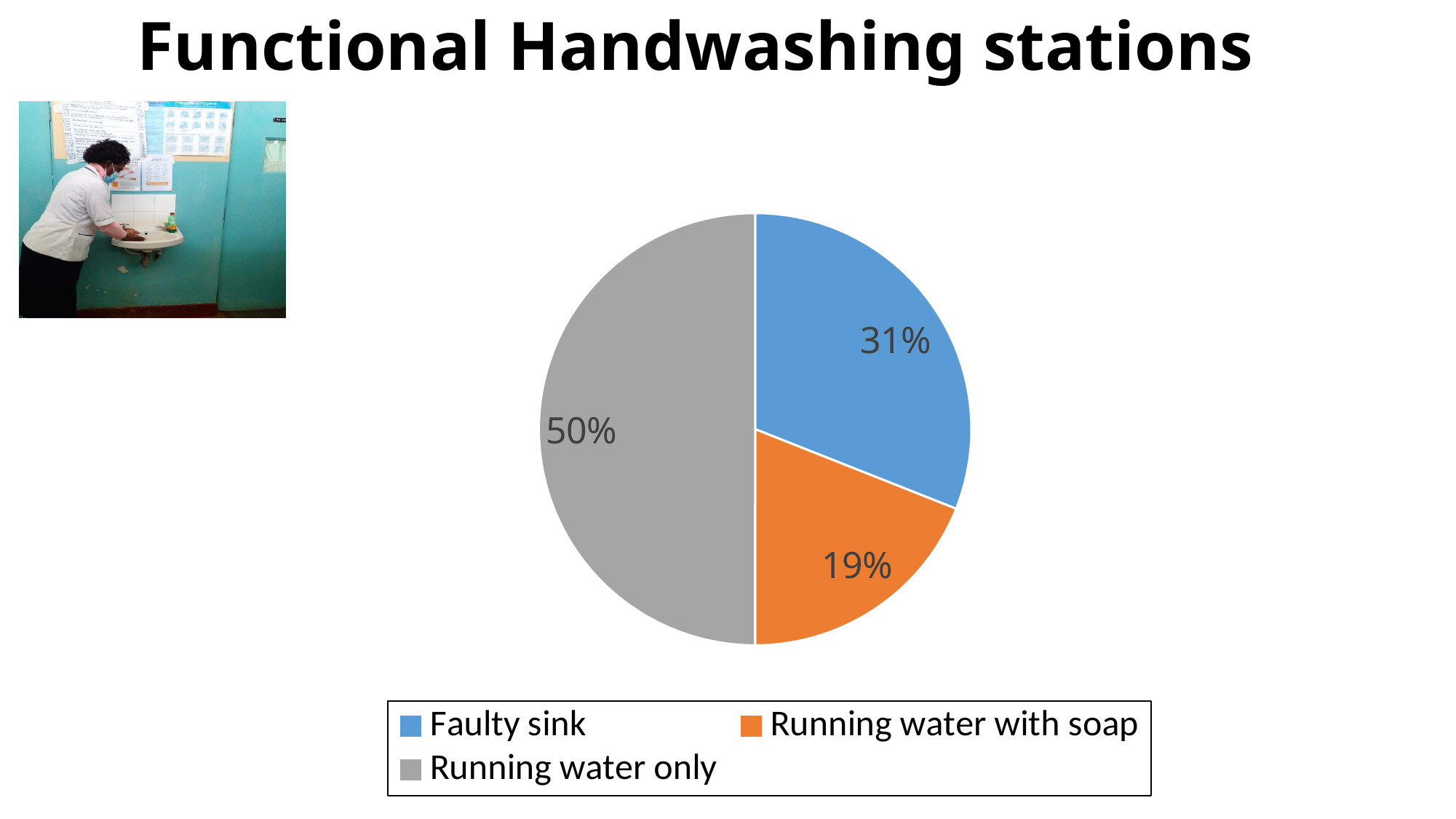
What is the title of the slide containing the pie chart? Functional Handwashing stations How many categories does the pie chart show? 3 What share of the pie is Running water with soap? 19% What is the difference between the Faulty sink share and the Running water with soap share? 12% Which category has the smallest slice of the pie? Running water with soap What kind of chart is shown on the slide? pie chart Which is larger, the Faulty sink slice or the Running water with soap slice? Faulty sink What is the difference between the Running water only share and the Faulty sink share? 19% What share of the pie is Faulty sink? 31% What colour is the Running water only slice? grey What share of the pie is Running water only? 50% Which category has the largest slice of the pie? Running water only